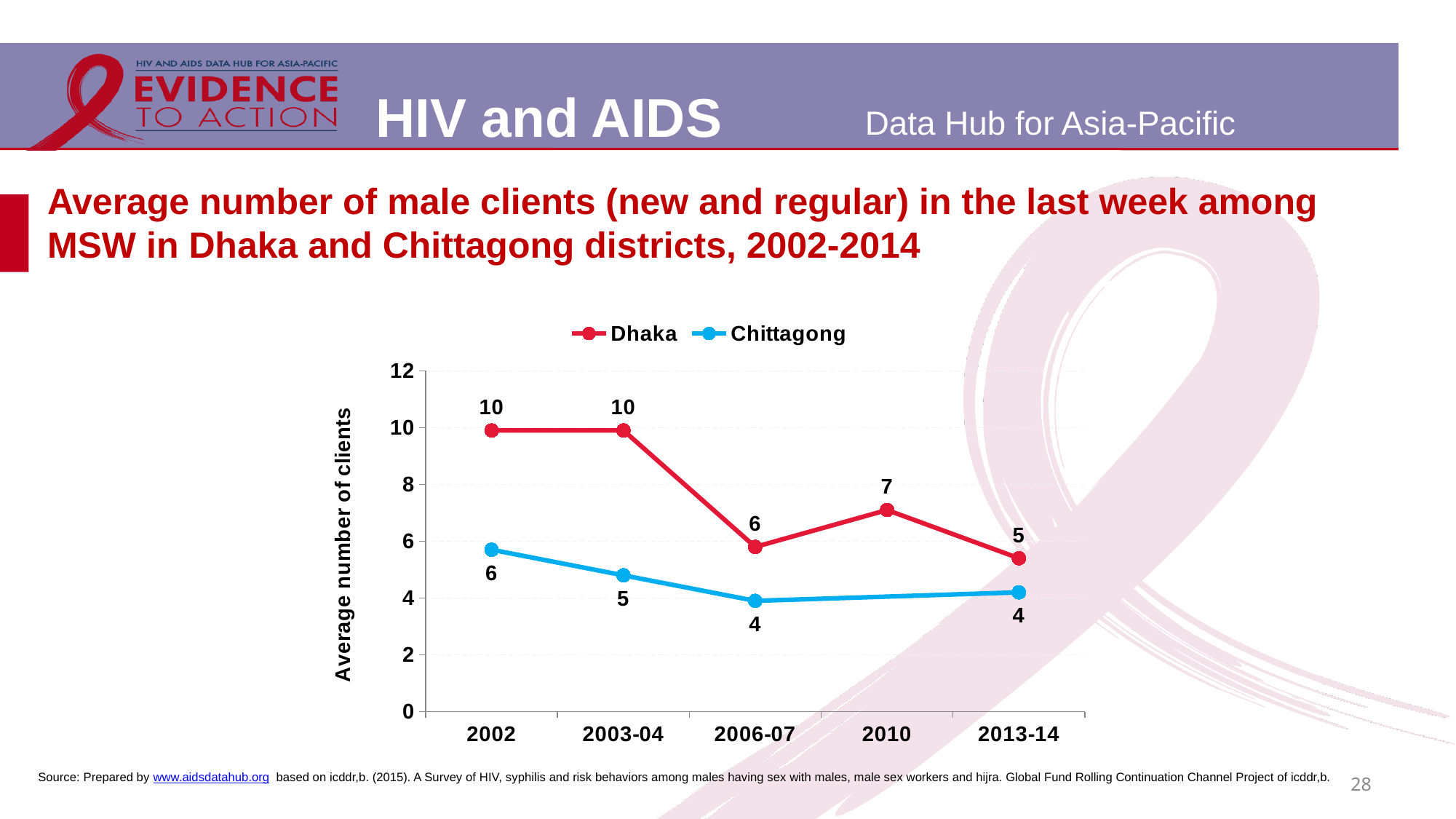
What is the difference between the Dhaka value in 2002 and the Dhaka value in 2013-14? 5 Is the value for Dhaka in 2003-04 greater or less than 8? greater How many time periods are shown on the x axis? 5 How many series does the legend list? 2 What is the average number of clients for Dhaka in 2002? 10 What kind of chart is shown on the slide? line chart What is the average number of clients for Chittagong in 2006-07? 4 What is the average number of clients for Chittagong in 2003-04? 5 What is the average number of clients for Dhaka in 2010? 7 Does the Chittagong line rise or fall from 2002 to 2006-07? fall In 2002, which district has the higher average number of clients, Dhaka or Chittagong? Dhaka In which period is the Dhaka value lowest? 2013-14